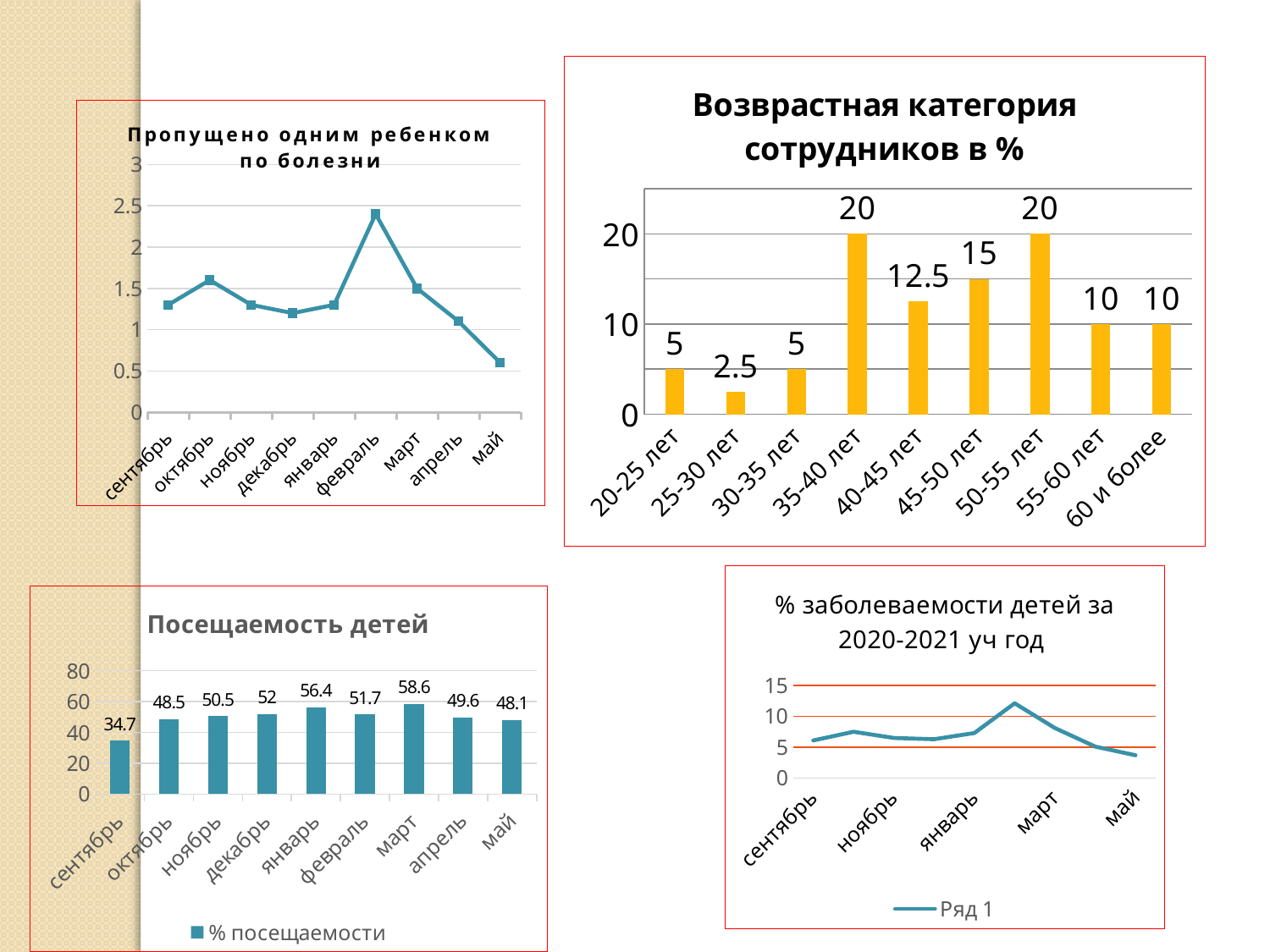
What type of chart is '% заболеваемости детей за 2020-2021 уч год'? line chart In the chart 'Пропущено одним ребенком по болезни', which month has the highest value? февраль In the chart 'Возврастная категория сотрудников в %', what is the difference between the values for 45-50 лет and 55-60 лет? 5 In the chart 'Посещаемость детей', which is larger, the value for январь or the value for февраль? январь In the chart 'Возврастная категория сотрудников в %', how many age categories are shown? 9 In the chart 'Возврастная категория сотрудников в %', which age category has the lowest value? 25-30 лет In the chart 'Возврастная категория сотрудников в %', what is the value for 40-45 лет? 12.5 In the chart 'Посещаемость детей', what is the difference between the values for март and сентябрь? 23.9 In the chart 'Посещаемость детей', what is the value for март? 58.6 In the chart 'Посещаемость детей', what series name is shown in the legend? % посещаемости In the chart 'Пропущено одним ребенком по болезни', is the value for май greater or less than 1? less In the chart 'Посещаемость детей', which month has the lowest value? сентябрь